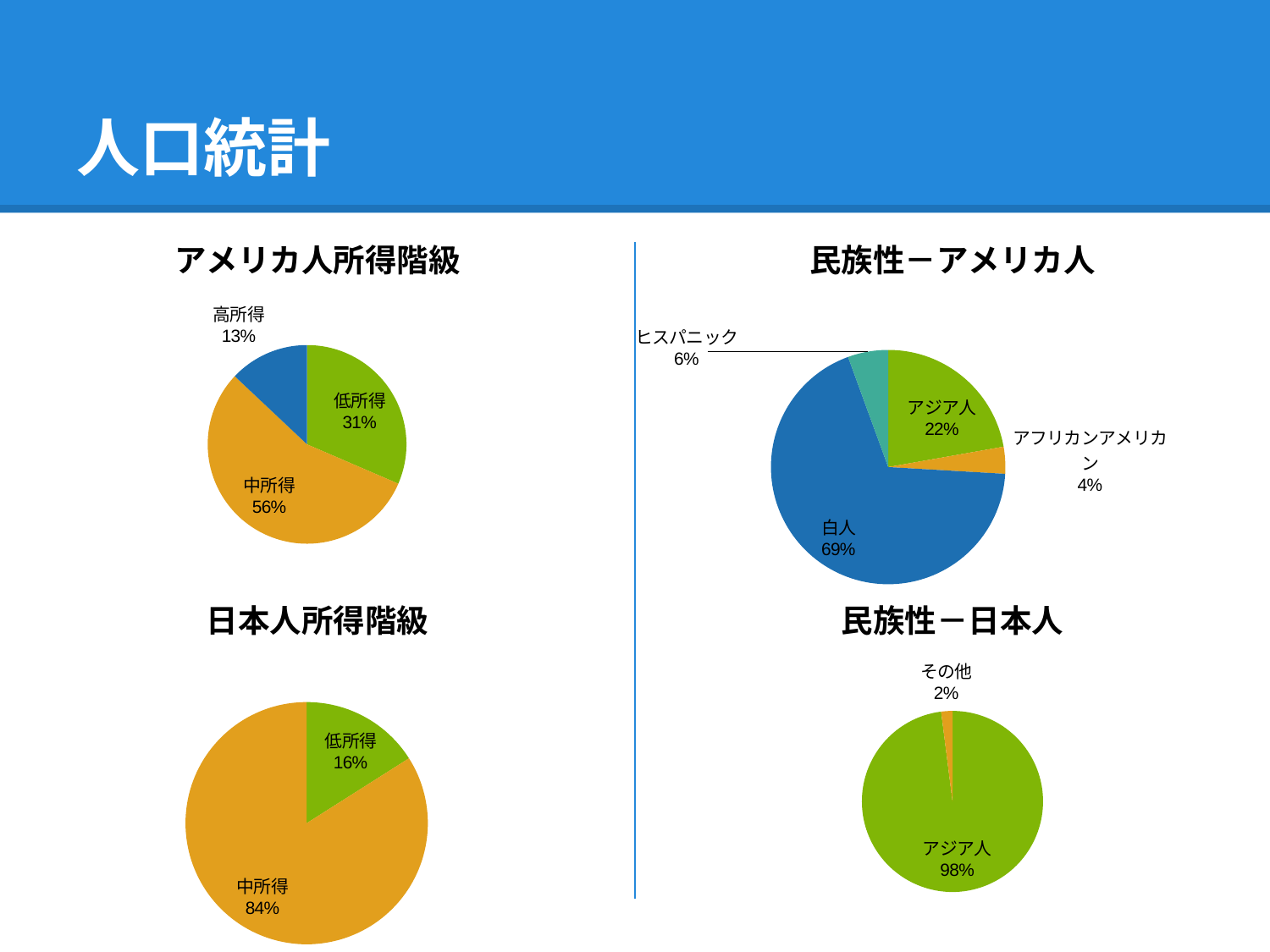
In the 日本人所得階級 chart, what share does 低所得 have? 16% In the 民族性－アメリカ人 chart, what share does ヒスパニック have? 6% What kind of chart is the 民族性－日本人 chart? Pie chart In the 日本人所得階級 chart, how many categories are shown? 2 In the 民族性－アメリカ人 chart, which is larger, アジア人 or アフリカンアメリカン? アジア人 In the アメリカ人所得階級 chart, what share does 中所得 have? 56% In the 民族性－アメリカ人 chart, how many categories are shown? 4 In the 民族性－アメリカ人 chart, which category has the largest share? 白人 In the アメリカ人所得階級 chart, what is the difference between the 低所得 and 高所得 shares? 18% In the 民族性－日本人 chart, what share does その他 have? 2% In the アメリカ人所得階級 chart, which category has the smallest share? 高所得 Which is larger, the 中所得 share in the アメリカ人所得階級 chart or the 中所得 share in the 日本人所得階級 chart? 日本人所得階級